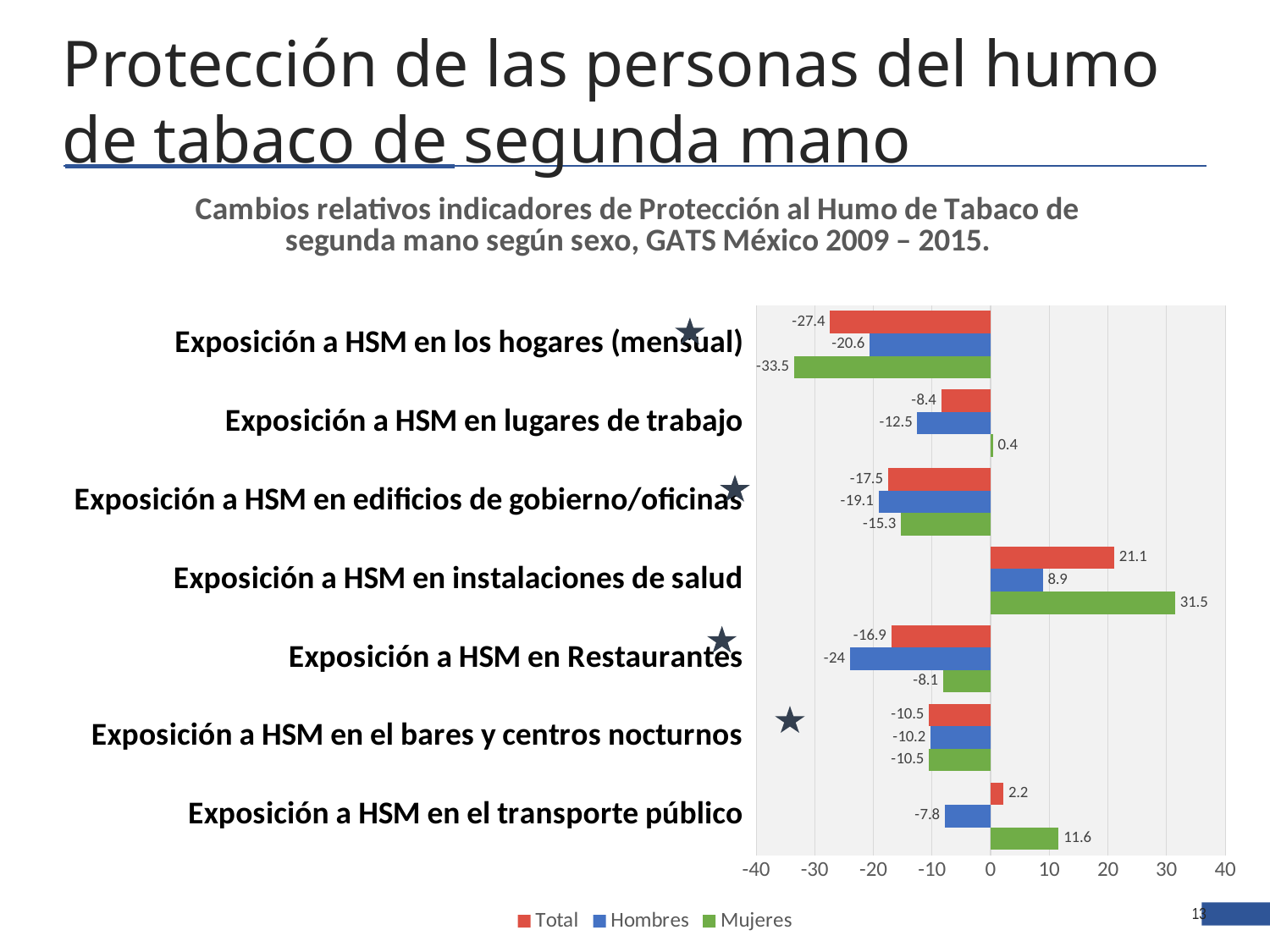
What is the Mujeres value for 'Exposición a HSM en instalaciones de salud'? 31.5 What is the Hombres value for 'Exposición a HSM en Restaurantes'? -24 What is the difference between the Mujeres and Hombres values for 'Exposición a HSM en instalaciones de salud'? 22.6 Which category has the lowest Total value? Exposición a HSM en los hogares (mensual) What is the Total value for 'Exposición a HSM en los hogares (mensual)'? -27.4 For 'Exposición a HSM en el transporte público', which is larger, the Total value or the Mujeres value? Mujeres What type of chart is shown on the slide? Bar chart Which series is shown in green in the legend? Mujeres What is the Mujeres value for 'Exposición a HSM en lugares de trabajo'? 0.4 Which category has the highest Mujeres value? Exposición a HSM en instalaciones de salud How many series does the legend list? 3 How many categories are plotted on the chart? 7